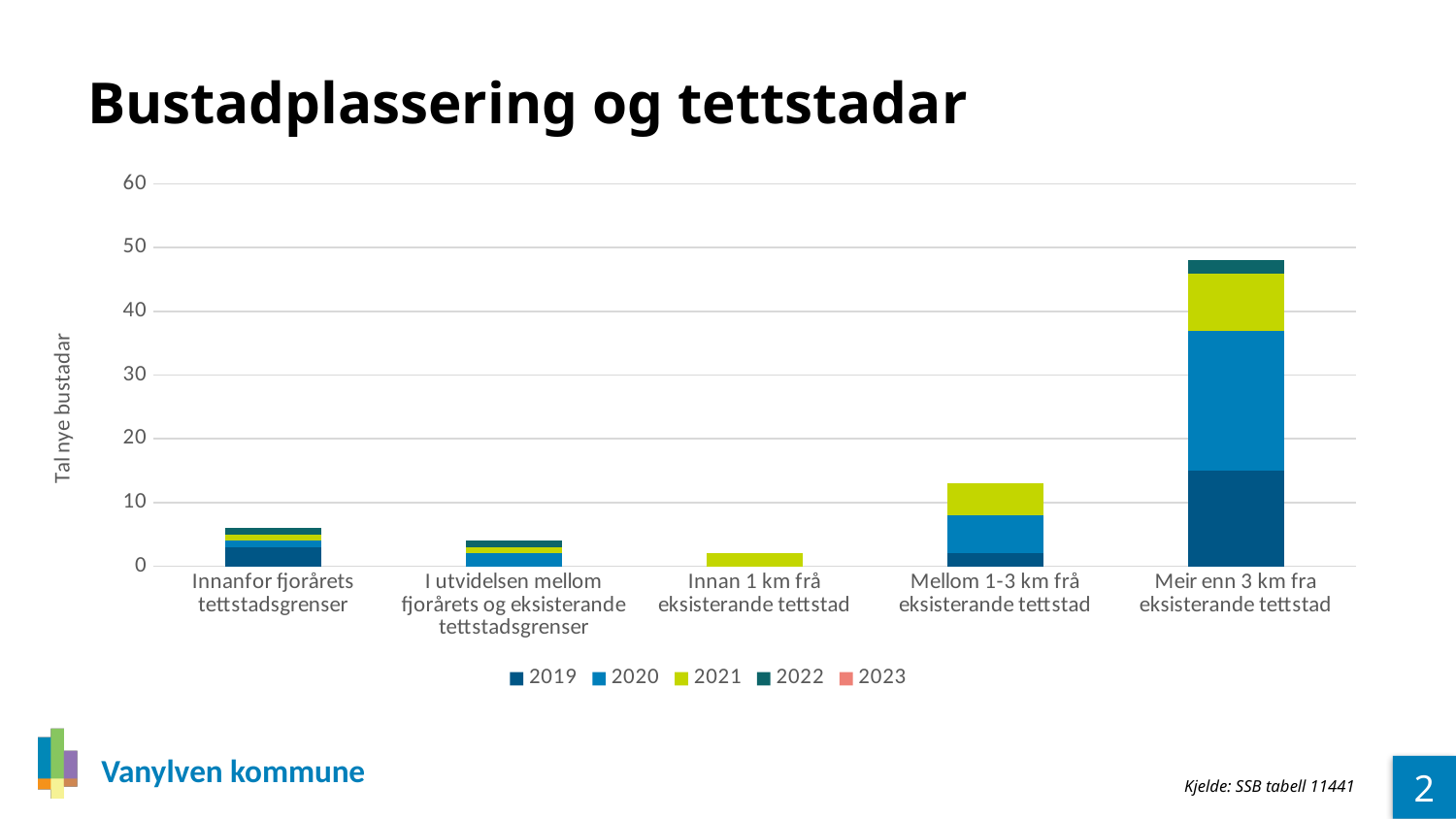
Which has the larger stacked total: 'Mellom 1-3 km frå eksisterande tettstad' or 'Innanfor fjorårets tettstadsgrenser'? Mellom 1-3 km frå eksisterande tettstad Which category has the shortest stacked bar? Innan 1 km frå eksisterande tettstad Which has the larger stacked total: 'Meir enn 3 km fra eksisterande tettstad' or 'Mellom 1-3 km frå eksisterande tettstad'? Meir enn 3 km fra eksisterande tettstad Is the total stacked value for 'Mellom 1-3 km frå eksisterande tettstad' greater or less than 10? greater Is the total stacked value for 'Innanfor fjorårets tettstadsgrenser' greater or less than 10? less What is the title of the chart? Bustadplassering og tettstadar Which category has the tallest stacked bar? Meir enn 3 km fra eksisterande tettstad What kind of chart is shown on the slide? Stacked bar chart Is the total stacked value for 'Meir enn 3 km fra eksisterande tettstad' greater or less than 40? greater What is the label on the y axis? Tal nye bustadar How many series does the legend list? 5 How many categories are shown on the x axis? 5